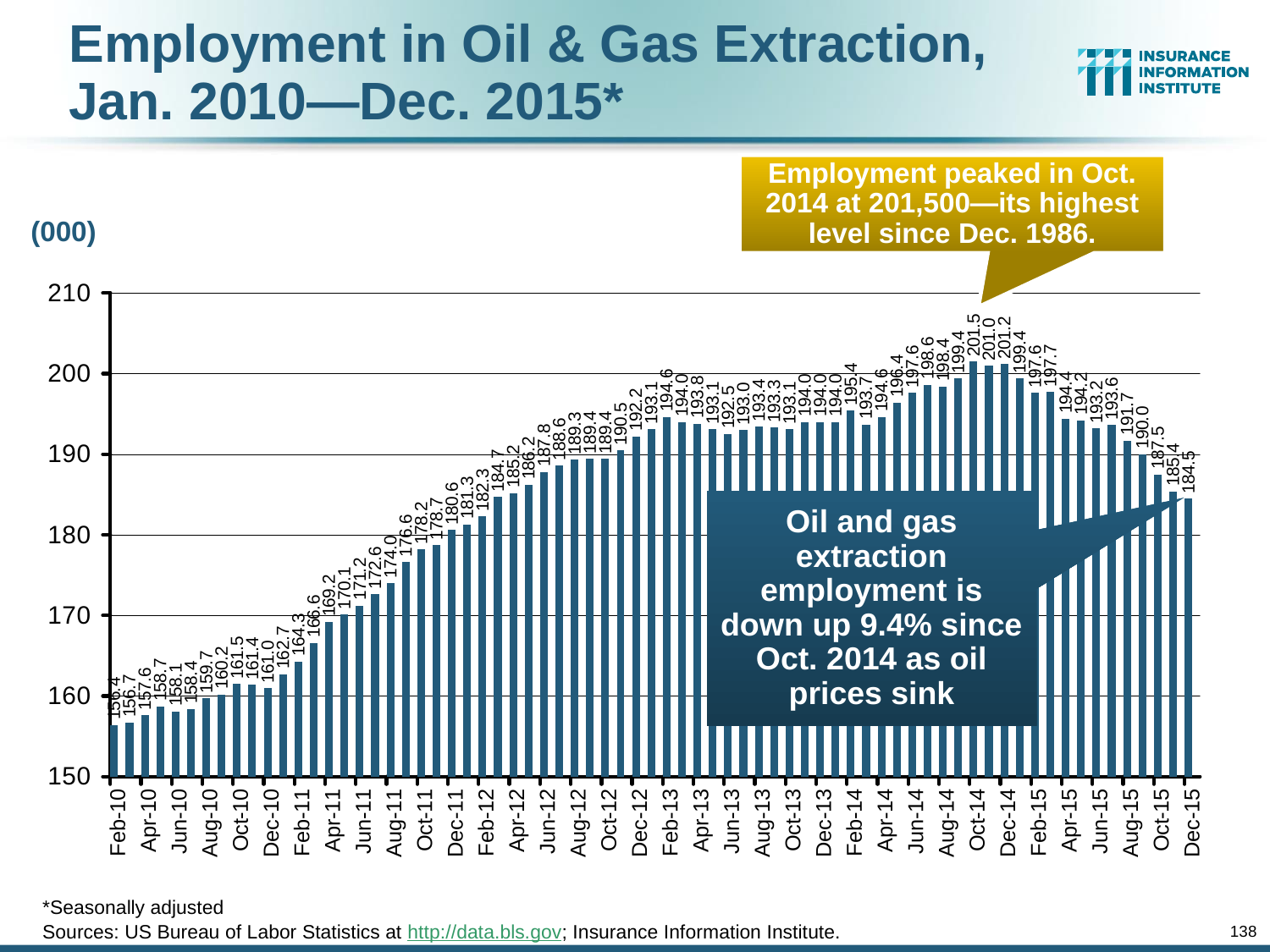
What was the employment value (in thousands) in Dec-15? 184.5 Do the values generally rise or fall from Feb-10 to Feb-13? rise Do the values rise or fall from Oct-14 to Dec-15? fall What kind of chart is shown on the slide? bar chart What is the difference between the Oct-14 value and the Dec-15 value? 17.0 What was the employment value (in thousands) in Oct-14? 201.5 Is the value for Oct-14 greater or less than 200? greater Which is larger, the value for Feb-10 or the value for Dec-15? Dec-15 Is the value for Dec-15 greater or less than 190? less What was the employment value (in thousands) in Feb-10? 156.4 According to the callout, by what percentage is oil and gas extraction employment down since Oct. 2014? 9.4% In which month did employment in oil & gas extraction reach its highest value? Oct-14